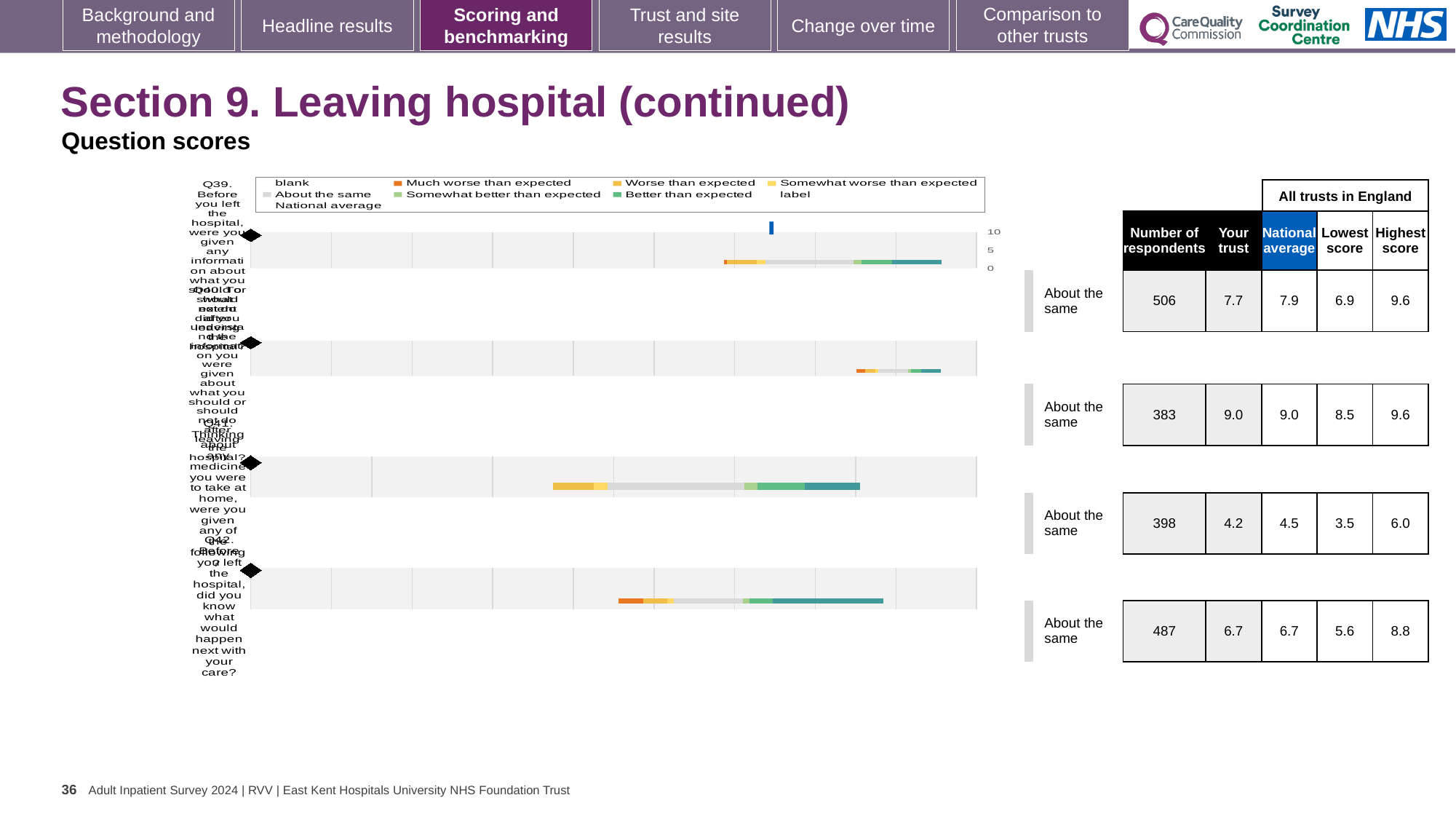
In the table beside the chart, what is the 'Your trust' score for Q41? 4.2 What kind of chart is shown on the slide? bar chart In the chart legend, what colour represents 'Much worse than expected'? orange In the table beside the chart, what is the number of respondents for Q39? 506 In the table beside the chart, what is the national average for Q42? 6.7 Which question has the lowest 'Your trust' score in the table beside the chart? Q41 For Q39, which is larger: the 'Your trust' score or the national average? National average In the chart legend, what colour represents 'Better than expected'? teal green In the table beside the chart, what is the highest score for Q40? 9.6 What is the difference between the national average and the 'Your trust' score for Q41? 0.3 Which question has the highest 'Your trust' score in the table beside the chart? Q40 How many questions (rows) are plotted in the chart? 4